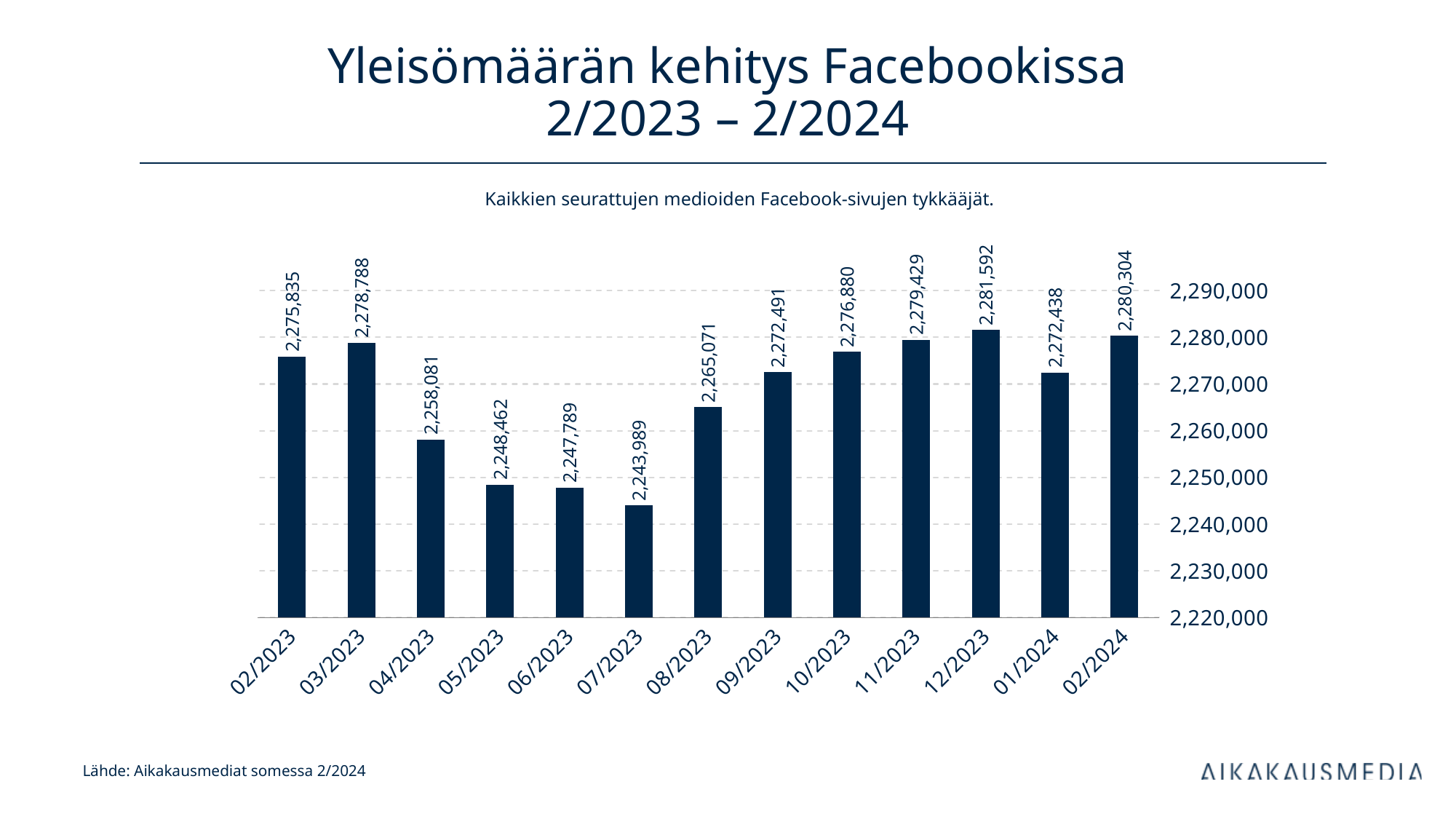
What is the difference between the values for 02/2024 and 02/2023? 4,469 What is the value for 07/2023? 2,243,989 How many months are shown on the x axis? 13 Which month has the highest value? 12/2023 Do the values rise or fall from 07/2023 to 12/2023? rise What kind of chart is shown on the slide? bar chart What is the difference between the highest value (12/2023) and the lowest value (07/2023)? 37,603 Which month has the lowest value? 07/2023 Is the value for 05/2023 greater or less than 2,250,000? less What is the value for 02/2023? 2,275,835 What is the value for 02/2024? 2,280,304 Which is larger, the value for 04/2023 or the value for 08/2023? 08/2023